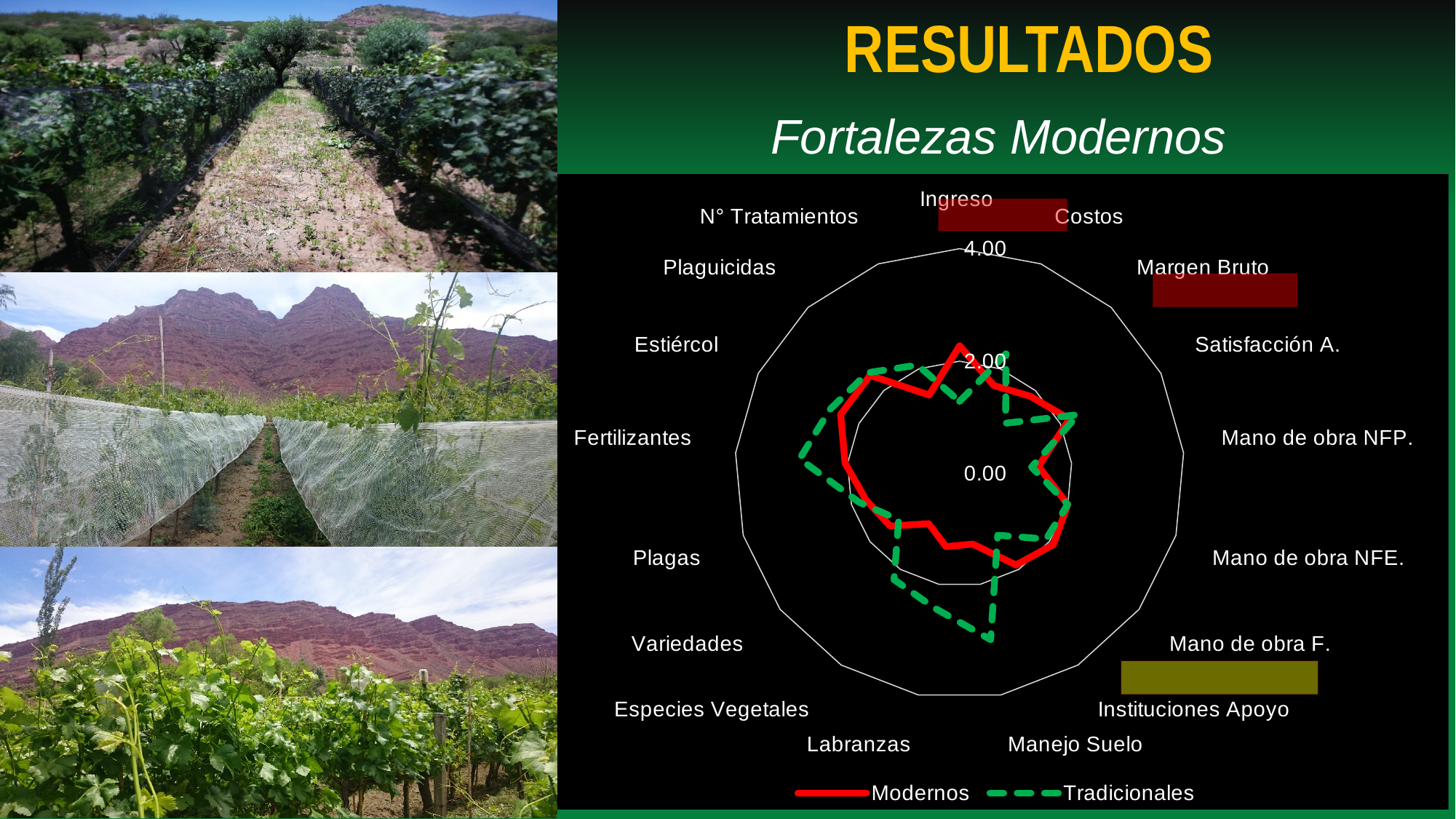
For Fertilizantes, which series has the larger value, Modernos or Tradicionales? Tradicionales How many series does the chart legend list? 2 Is the Modernos value for Mano de obra NFP. greater or less than 2.00? less What kind of chart is shown on the slide? Radar chart For Manejo Suelo, which series has the larger value, Modernos or Tradicionales? Tradicionales Is the Tradicionales value for Manejo Suelo greater or less than 2.00? greater What is the highest value labelled on the chart's radial axis? 4.00 Is the Tradicionales value for Fertilizantes greater or less than 2.00? greater For Labranzas, which series has the larger value, Modernos or Tradicionales? Tradicionales How many categories (axes) does the radar chart have? 17 Which series is drawn with the dashed green line? Tradicionales